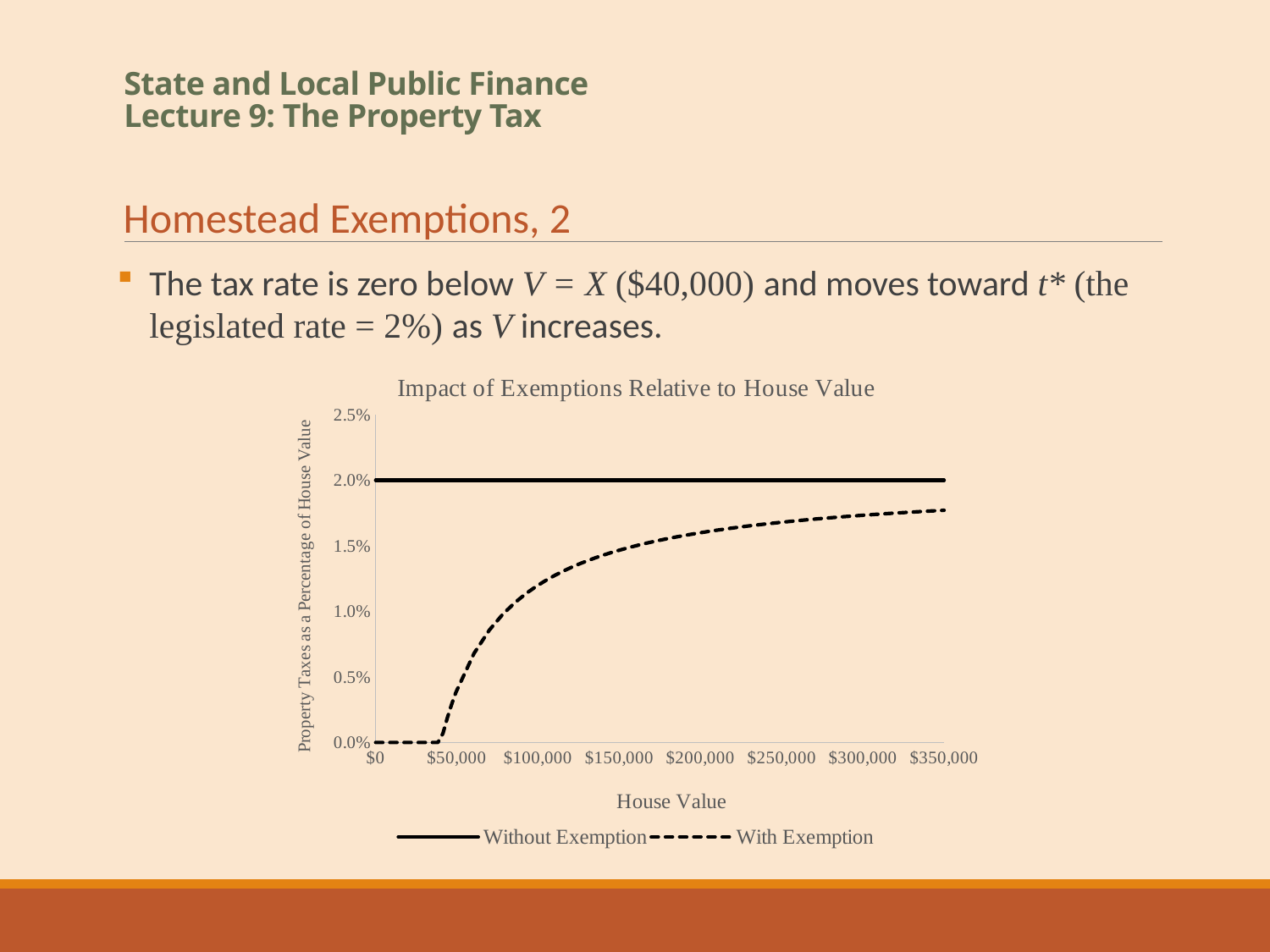
What kind of chart is shown on the slide? line chart Does the With Exemption line rise or fall as house value increases? rise What is the value of the Without Exemption line across all house values? 2.0% What is the label of the x axis? House Value Is the With Exemption value at $100,000 greater or less than 1.5%? less What is the value of the With Exemption line at a house value of $0? 0.0% Is the With Exemption value at $200,000 greater or less than 1.0%? greater Which series is drawn with a dashed line? With Exemption What is the title of the chart? Impact of Exemptions Relative to House Value Is the With Exemption value at $350,000 greater or less than 2.0%? less At a house value of $150,000, which series has the larger value, Without Exemption or With Exemption? Without Exemption How many series does the chart's legend list? 2